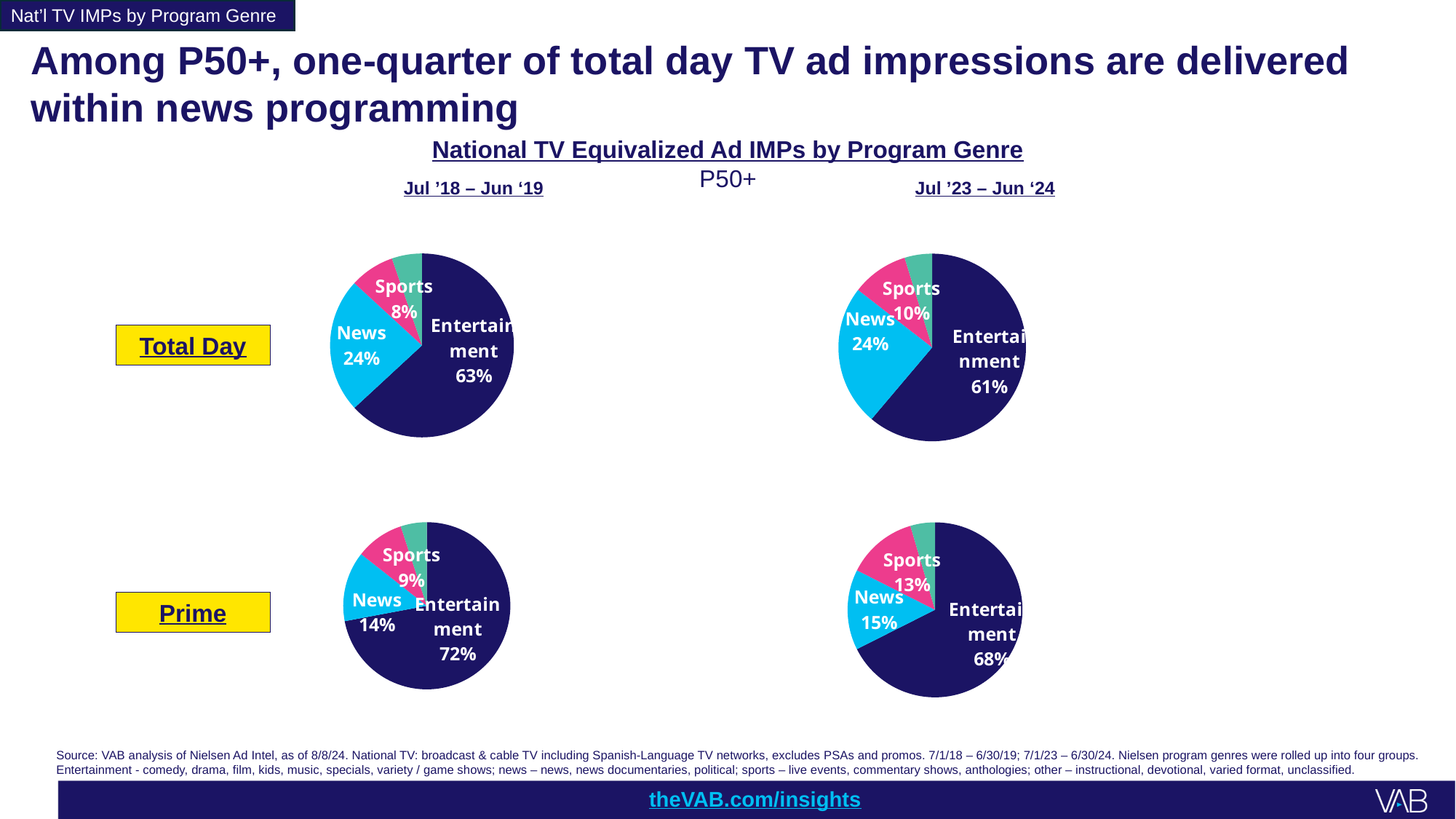
Which is larger: the Sports share in the Total Day chart for Jul '23 – Jun '24 or the Sports share in the Total Day chart for Jul '18 – Jun '19? Jul '23 – Jun '24 How many pie charts are shown on the slide? 4 What is the difference between the Entertainment share and the News share in the Total Day pie chart for Jul '23 – Jun '24? 37 percentage points In the Prime pie chart for Jul '18 – Jun '19, what is the Sports share? 9% In the Prime pie chart for Jul '23 – Jun '24, which labeled genre has the largest share? Entertainment What is the title of the chart group on the slide? National TV Equivalized Ad IMPs by Program Genre In the Total Day pie chart for Jul '18 – Jun '19, what share of ad impressions is delivered within news programming? 24% In the Total Day pie chart for Jul '23 – Jun '24, what share does Entertainment hold? 61% In the Total Day pie chart for Jul '18 – Jun '19, which labeled genre has the smallest share? Sports In the Prime pie chart for Jul '23 – Jun '24, what is the News share? 15% What type of chart is used to show the ad impressions by program genre on this slide? Pie chart What is the difference in the Entertainment share between the Prime pie charts for Jul '18 – Jun '19 and Jul '23 – Jun '24? 4 percentage points